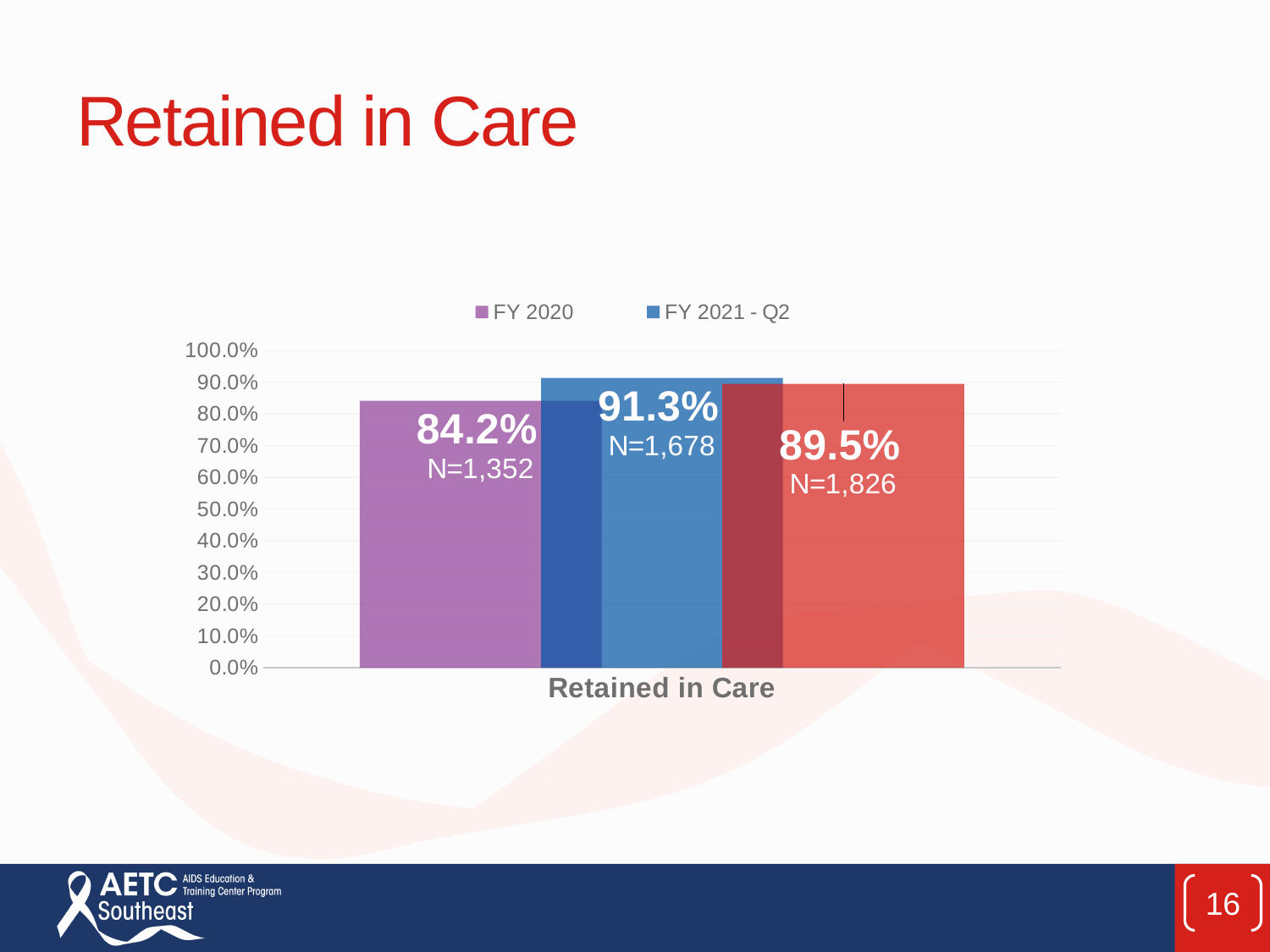
Which bar in the chart has the lowest value? FY 2020 (84.2%) What is the difference between the FY 2021 - Q2 value and the FY 2020 value? 7.1 percentage points What N value is printed on the FY 2021 - Q2 bar? N=1,678 How many bars are plotted in the chart? 3 What is the value shown for FY 2021 - Q2 in the Retained in Care chart? 91.3% What percentage is printed on the red bar on the right of the chart? 89.5% How many series does the legend list? 2 Which is larger: the FY 2020 value or the value on the red bar? The red bar (89.5%) What is the value shown for FY 2020 in the Retained in Care chart? 84.2% What N value is printed on the FY 2020 bar? N=1,352 What type of chart is shown on the slide? Bar chart Which bar in the chart has the highest value? FY 2021 - Q2 (91.3%)